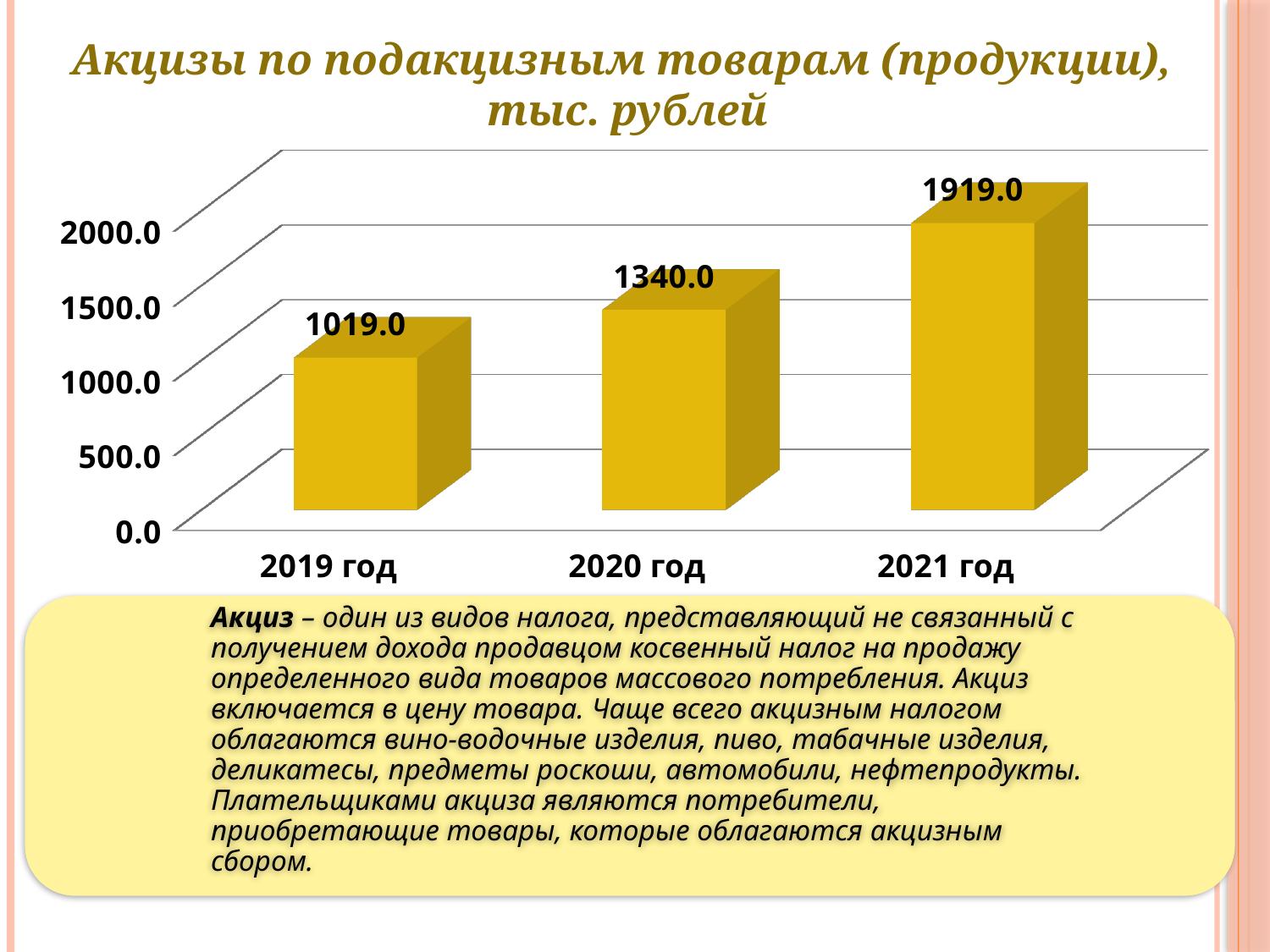
What kind of chart is shown on the slide? bar chart What is the value for 2020 год? 1340.0 Is the value for 2021 год greater or less than 1500.0? greater How many years are shown on the chart? 3 What is the difference between the values for 2020 год and 2019 год? 321.0 What is the difference between the values for 2021 год and 2019 год? 900.0 What is the value for 2019 год? 1019.0 Which year has the lowest value? 2019 год What is the value for 2021 год? 1919.0 Which year has the highest value? 2021 год Which is larger, the value for 2020 год or the value for 2021 год? 2021 год Do the values rise or fall from 2019 год to 2021 год? rise